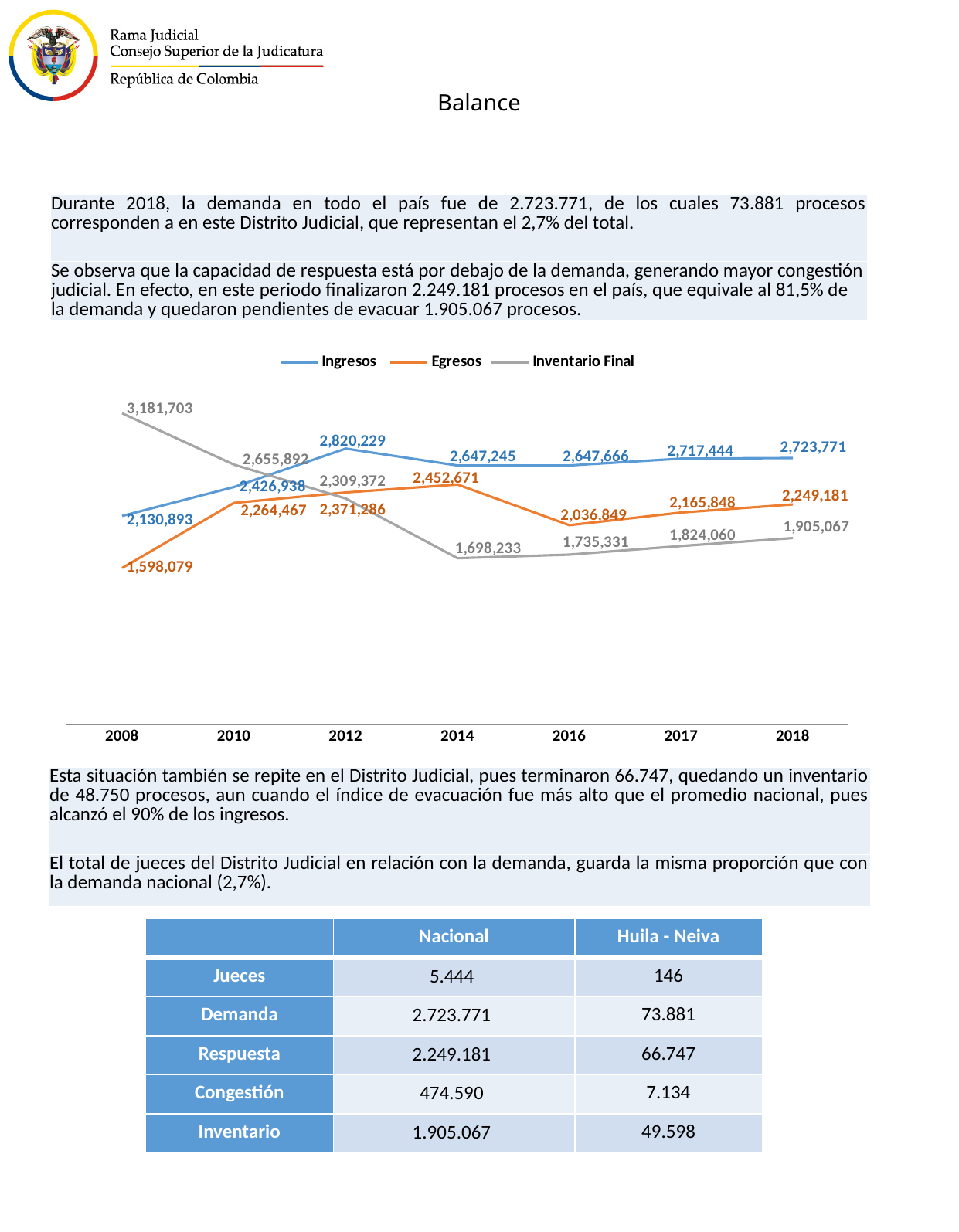
What kind of chart is shown? Line chart How many years are shown on the x axis? 7 What is the value of Inventario Final in 2014? 1,698,233 Does Inventario Final rise or fall from 2008 to 2014? Fall What is the value of Egresos in 2008? 1,598,079 In which year is Egresos lowest? 2008 What is the difference between Ingresos and Egresos in 2018? 474,590 What is the value of Ingresos in 2012? 2,820,229 In which year is Ingresos highest? 2012 In which year is Inventario Final highest? 2008 How many series does the legend list? 3 In 2010, which is larger: Ingresos or Inventario Final? Inventario Final